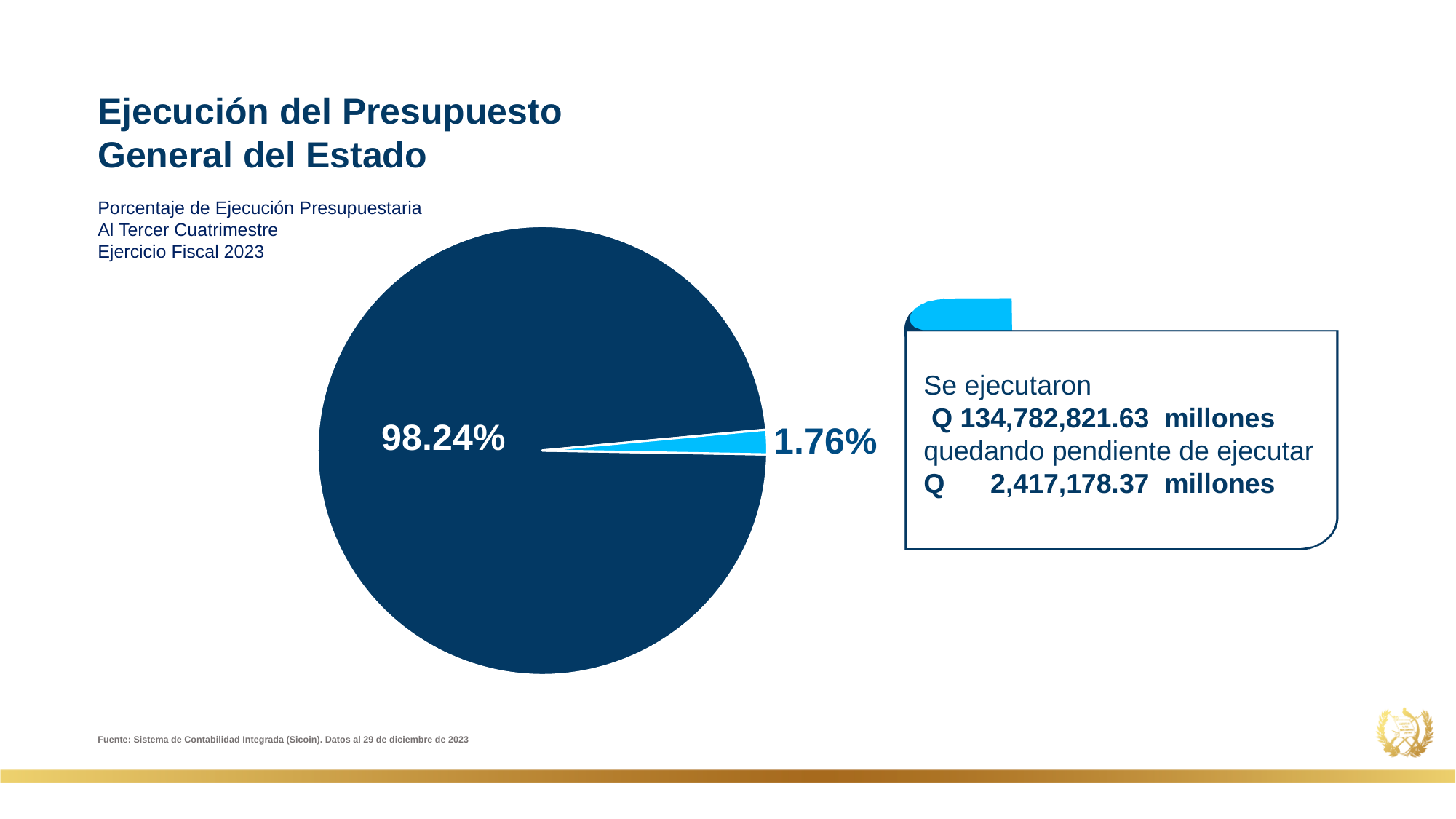
What share of the pie does the dark blue slice represent? 98.24% Is the value of the light blue slice greater or less than 10%? less What colour is the slice labelled 1.76%? Light blue What is the title of the chart shown on the slide? Porcentaje de Ejecución Presupuestaria Al Tercer Cuatrimestre Ejercicio Fiscal 2023 How many slices does the pie chart have? 2 What is the total of the two slice values shown on the pie chart? 100% What is the value of the largest slice of the pie chart? 98.24% Which slice is larger, the dark blue one or the light blue one? The dark blue one What is the value of the smallest slice of the pie chart? 1.76% What kind of chart is shown on the slide? Pie chart What is the difference in percentage points between the two slices of the pie chart? 96.48 What share of the pie does the light blue slice represent? 1.76%